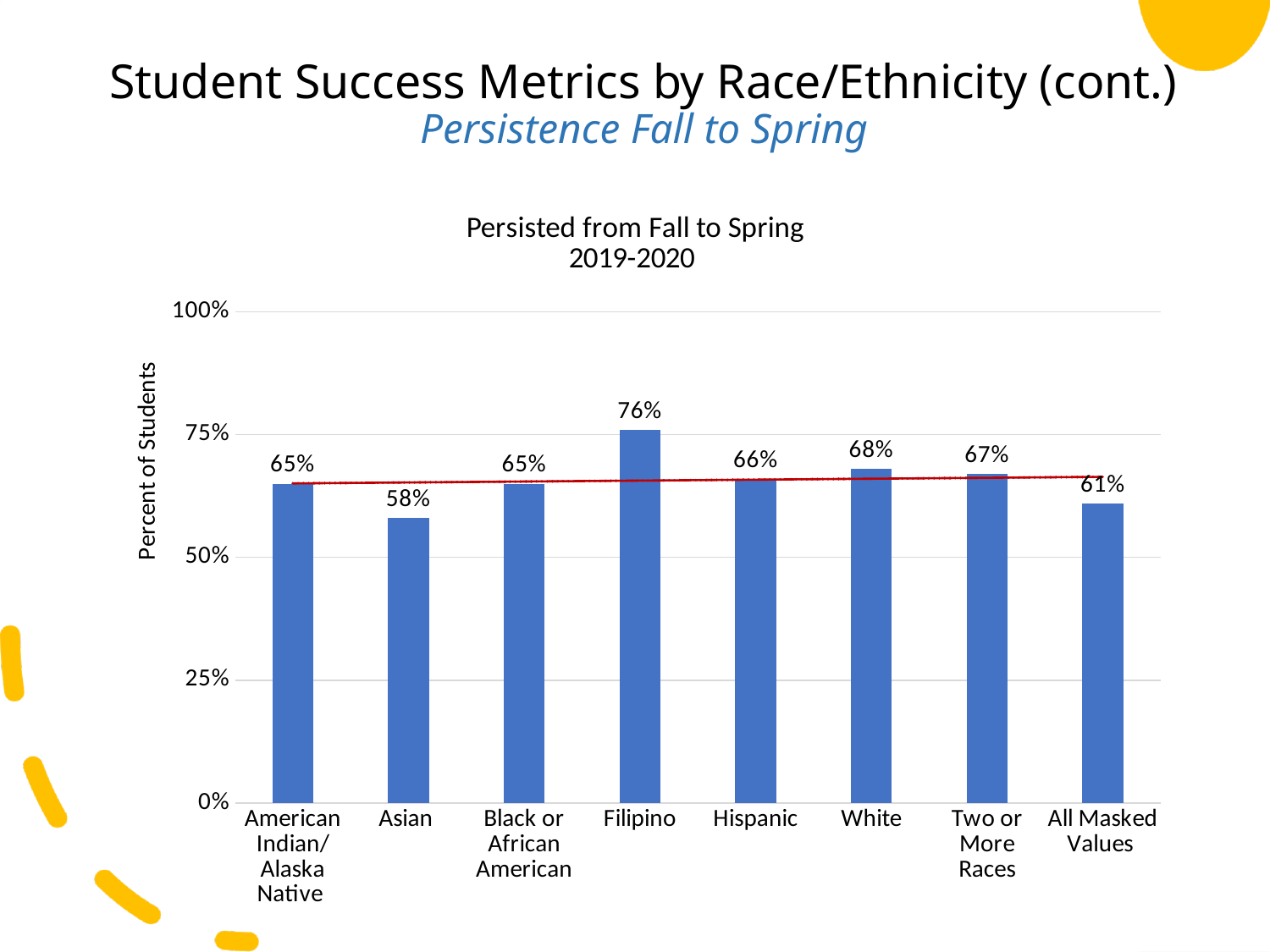
How many categories are shown on the x axis? 8 What is the value for White? 68% What is the title of the chart? Persisted from Fall to Spring 2019-2020 Which category has the lowest value? Asian Is the value for Two or More Races greater or less than 50%? greater What is the value for All Masked Values? 61% Which category has the highest value? Filipino What is the value for Filipino? 76% What is the difference between the values for Filipino and Asian? 18% What is the value for Asian? 58% What kind of chart is this? bar chart Which is larger, the value for White or the value for Hispanic? White